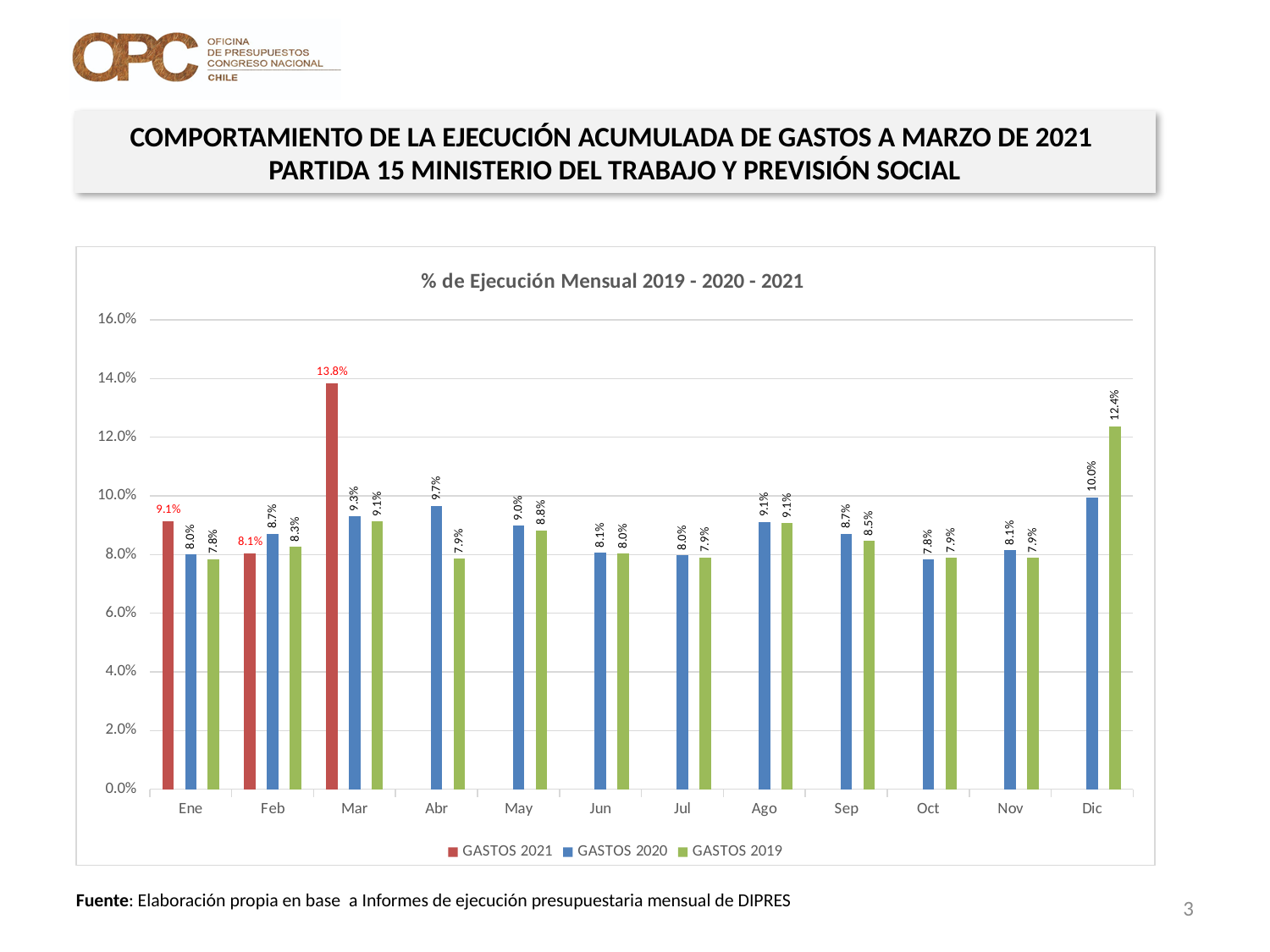
What is the difference between GASTOS 2021 and GASTOS 2020 in Mar? 4.5% In which month is the GASTOS 2020 value lowest? Oct What is the value for GASTOS 2019 in Dic? 12.4% How many months are shown on the x axis? 12 In which month is the GASTOS 2019 value highest? Dic What type of chart is shown on the slide? bar chart Which is larger in Feb, GASTOS 2021 or GASTOS 2020? GASTOS 2020 How many series does the legend list? 3 Is the value for GASTOS 2020 in Dic greater or less than 12.0%? less What is the value for GASTOS 2021 in Mar? 13.8% What is the title of the chart? % de Ejecución Mensual 2019 - 2020 - 2021 What is the value for GASTOS 2020 in Abr? 9.7%